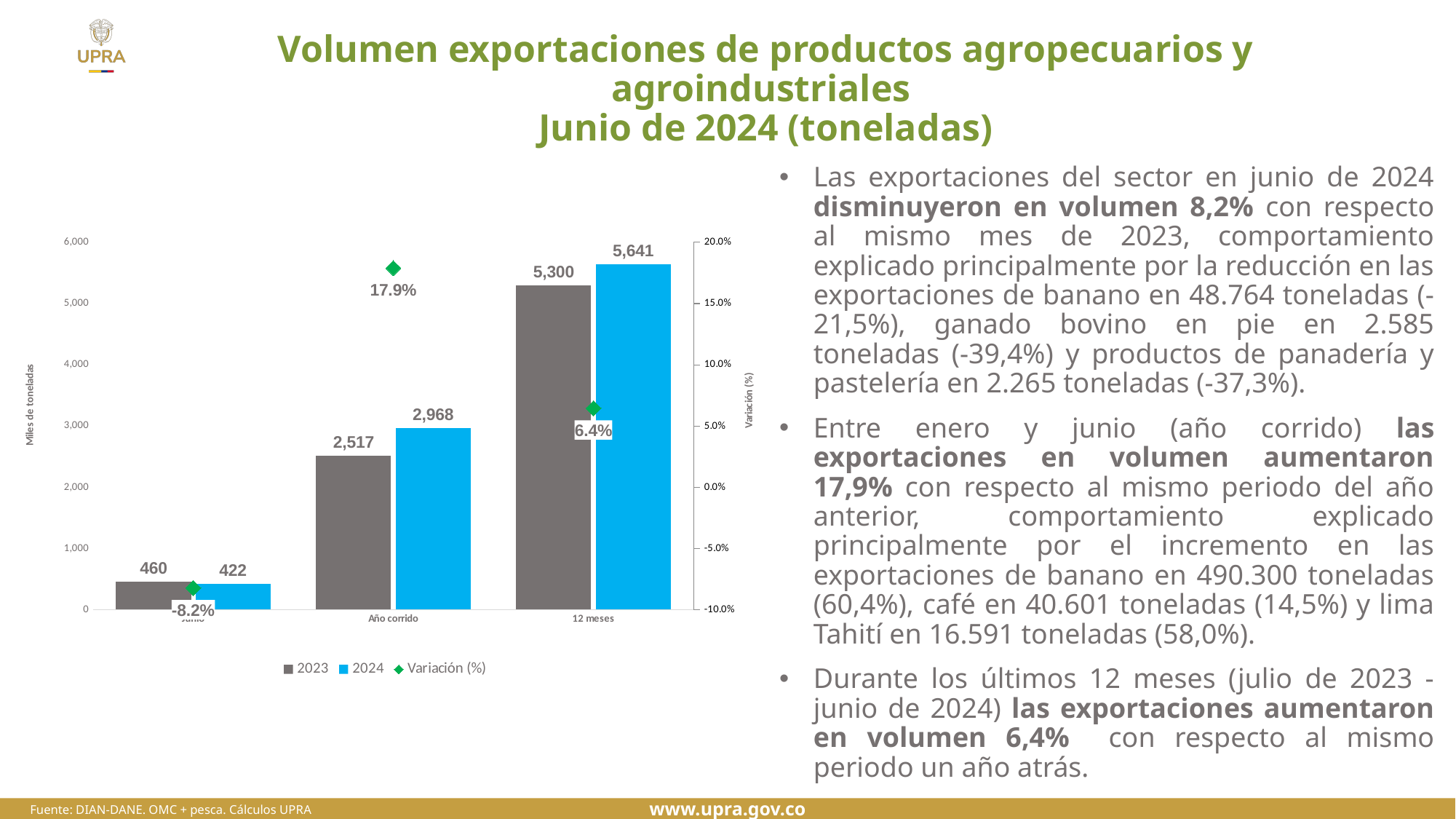
What is the label of the left vertical axis? Miles de toneladas What is the 2024 value for Año corrido? 2,968 Which is larger for Junio, the 2023 value or the 2024 value? 2023 Which category has the highest 2024 value? 12 meses How many series does the legend list? 3 What is the difference between the 2024 and 2023 values for 12 meses? 341 What is the Variación (%) value shown for Junio? -8.2% Which category has the lowest 2023 value? Junio What is the Variación (%) value shown for Año corrido? 17.9% What is the 2023 value for 12 meses? 5,300 What kind of chart is shown on the slide? Bar chart with a line/marker series How many categories are shown on the x axis? 3